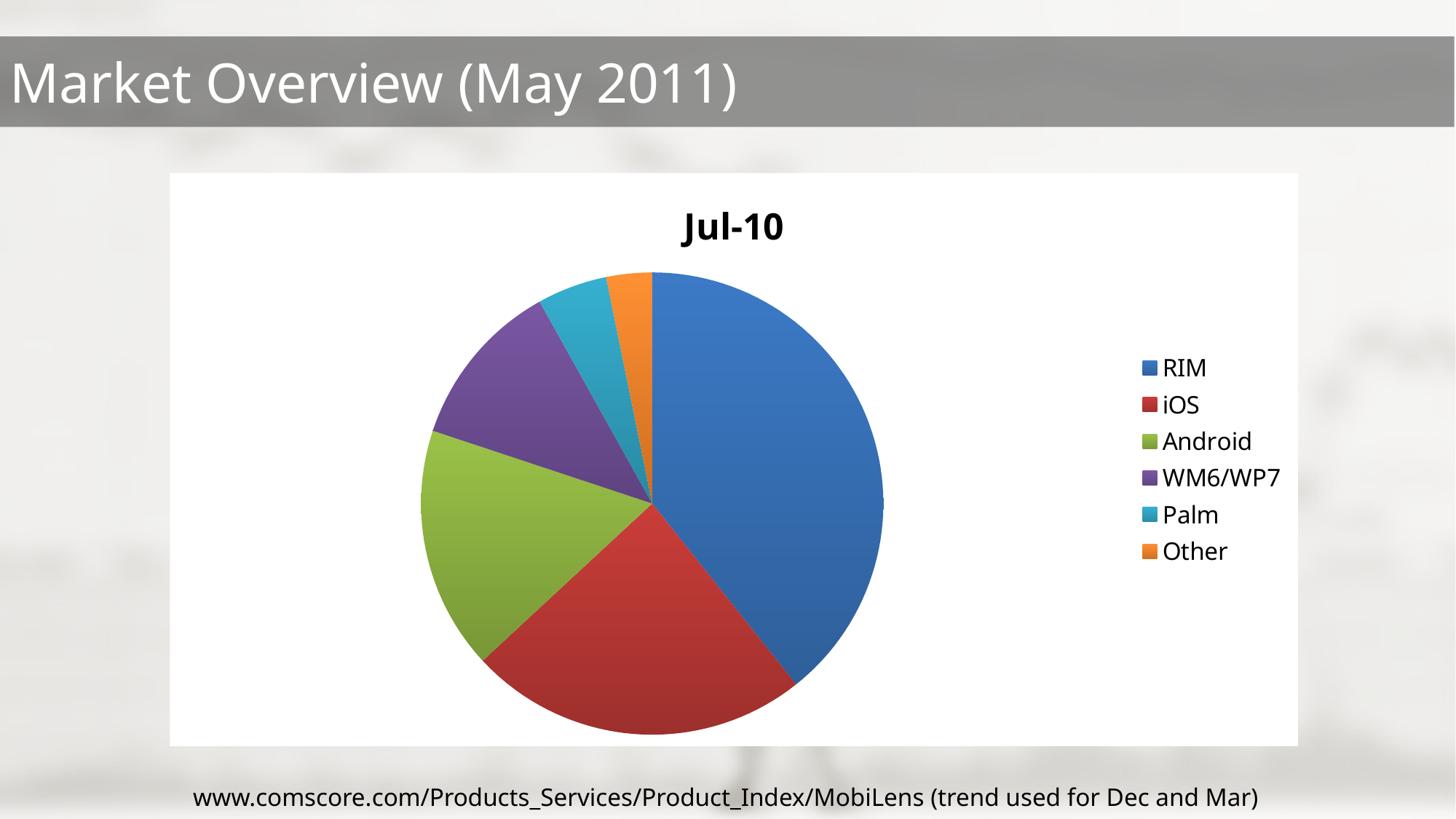
How many entries does the legend list? 6 Which category has the largest slice of the pie? RIM Which slice is larger, Palm or Other? Palm Which slice is larger, Android or WM6/WP7? Android Which slice is larger, iOS or Android? iOS What colour is the slice for Android in the pie chart? Green How many categories does the pie chart show? 6 What kind of chart is shown on the slide? Pie chart Which category has the smallest slice of the pie? Other What is the title of the chart? Jul-10